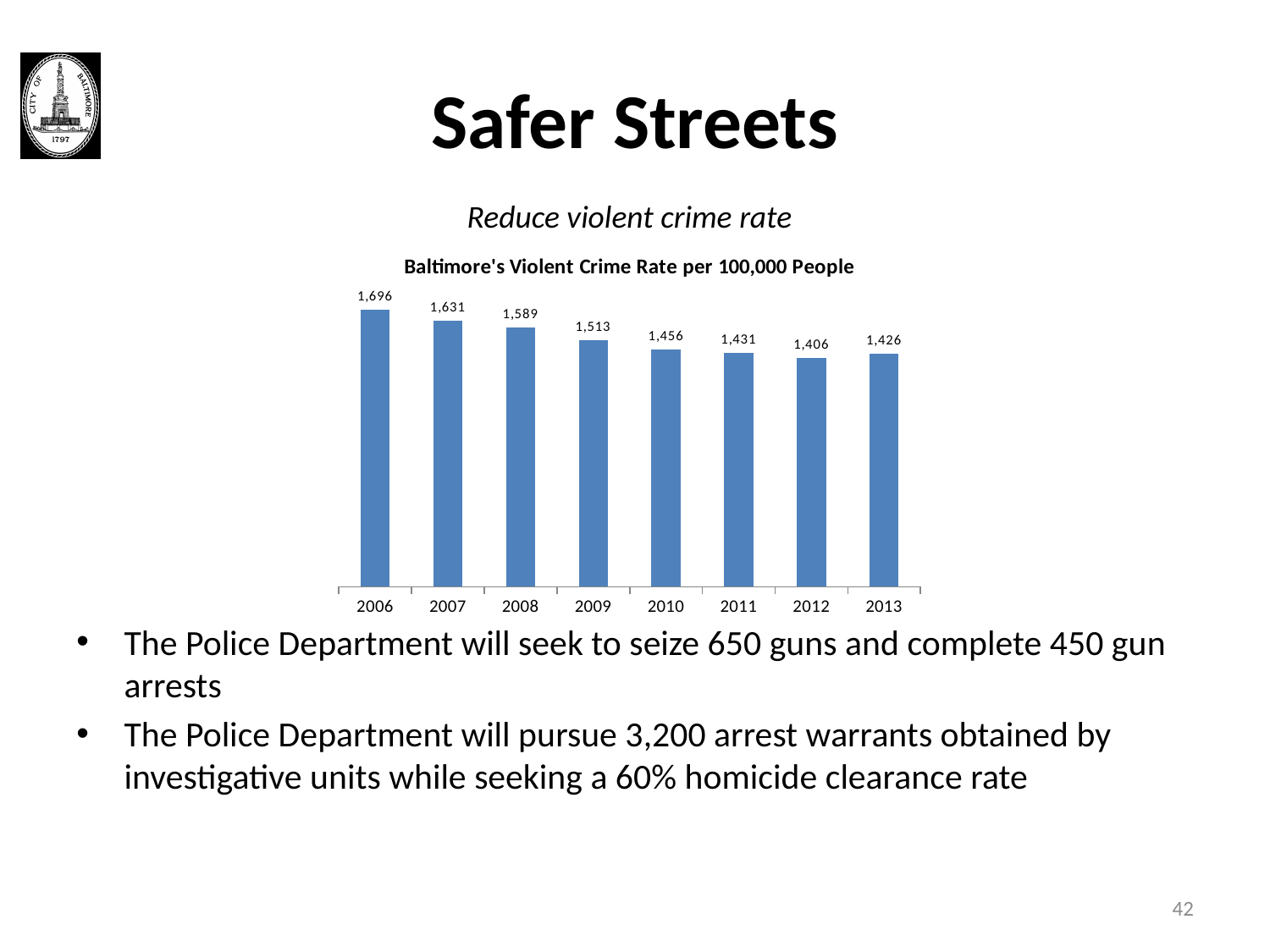
What type of chart is used to show Baltimore's violent crime rate? Bar chart Which year has a higher violent crime rate, 2008 or 2011? 2008 By how much did the violent crime rate change from 2012 to 2013? 20 What is the overall trend of the violent crime rate from 2006 to 2012? Falling What is Baltimore's violent crime rate per 100,000 people in 2006? 1,696 What is the title of the chart? Baltimore's Violent Crime Rate per 100,000 People How many years are shown on the chart? 8 What is the violent crime rate shown for 2013? 1,426 What is the violent crime rate shown for 2010? 1,456 What is the difference between the violent crime rate in 2006 and in 2013? 270 Which year has the lowest violent crime rate? 2012 Which year has the highest violent crime rate? 2006